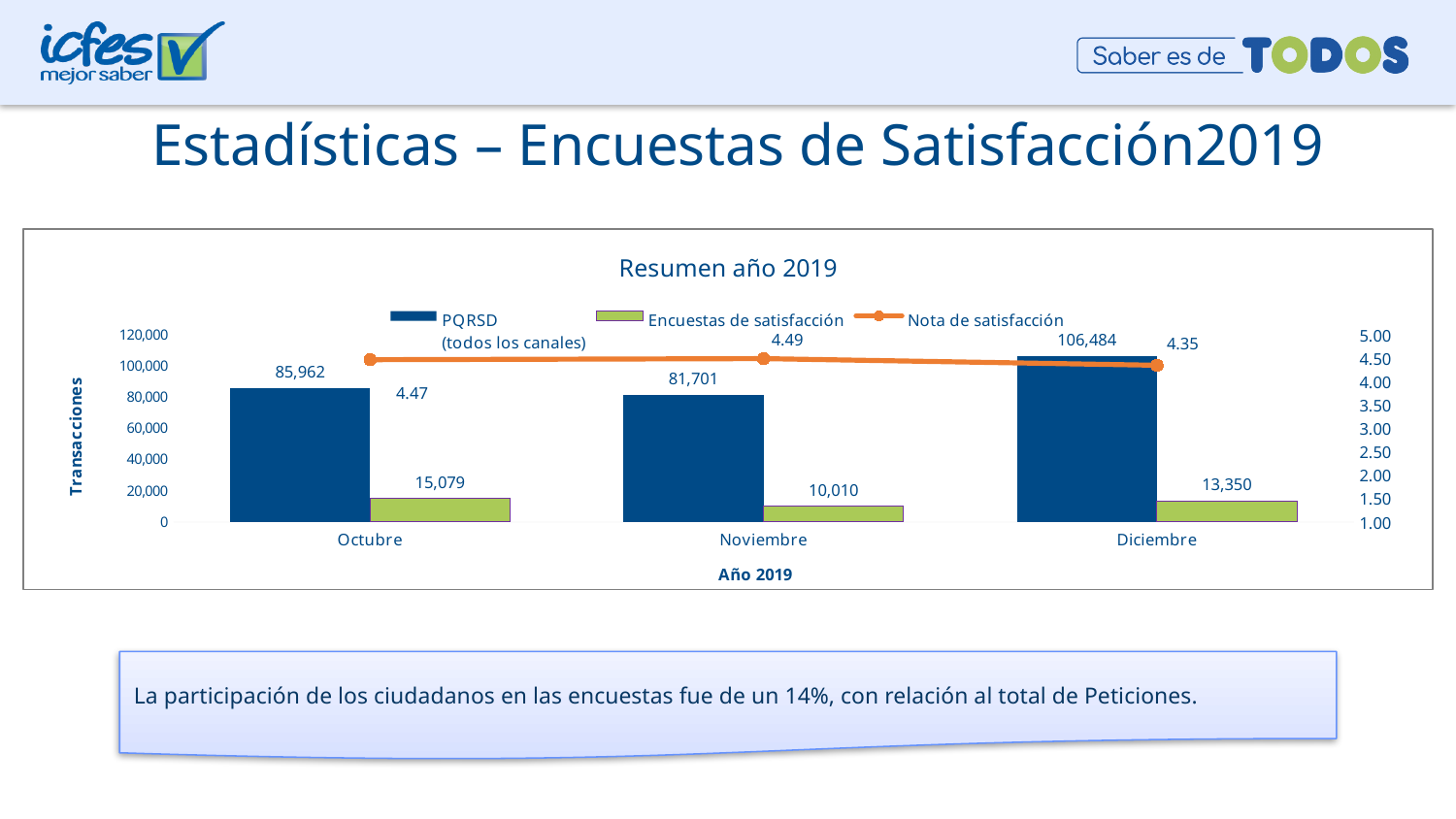
What is the Nota de satisfacción for Diciembre? 4.35 Which month has the lowest Encuestas de satisfacción value? Noviembre How many months are shown on the x axis of the chart? 3 What is the difference between the PQRSD values for Diciembre and Noviembre? 24,783 Which is larger, the Encuestas de satisfacción value for Octubre or for Diciembre? Octubre What is the title of the chart? Resumen año 2019 How many series does the legend list? 3 What kind of chart is used to show the PQRSD and Encuestas de satisfacción series? Bar chart What is the Encuestas de satisfacción value for Noviembre? 10,010 Does the Nota de satisfacción rise or fall from Noviembre to Diciembre? Fall What is the PQRSD (todos los canales) value for Octubre? 85,962 Which month has the highest PQRSD (todos los canales) value? Diciembre